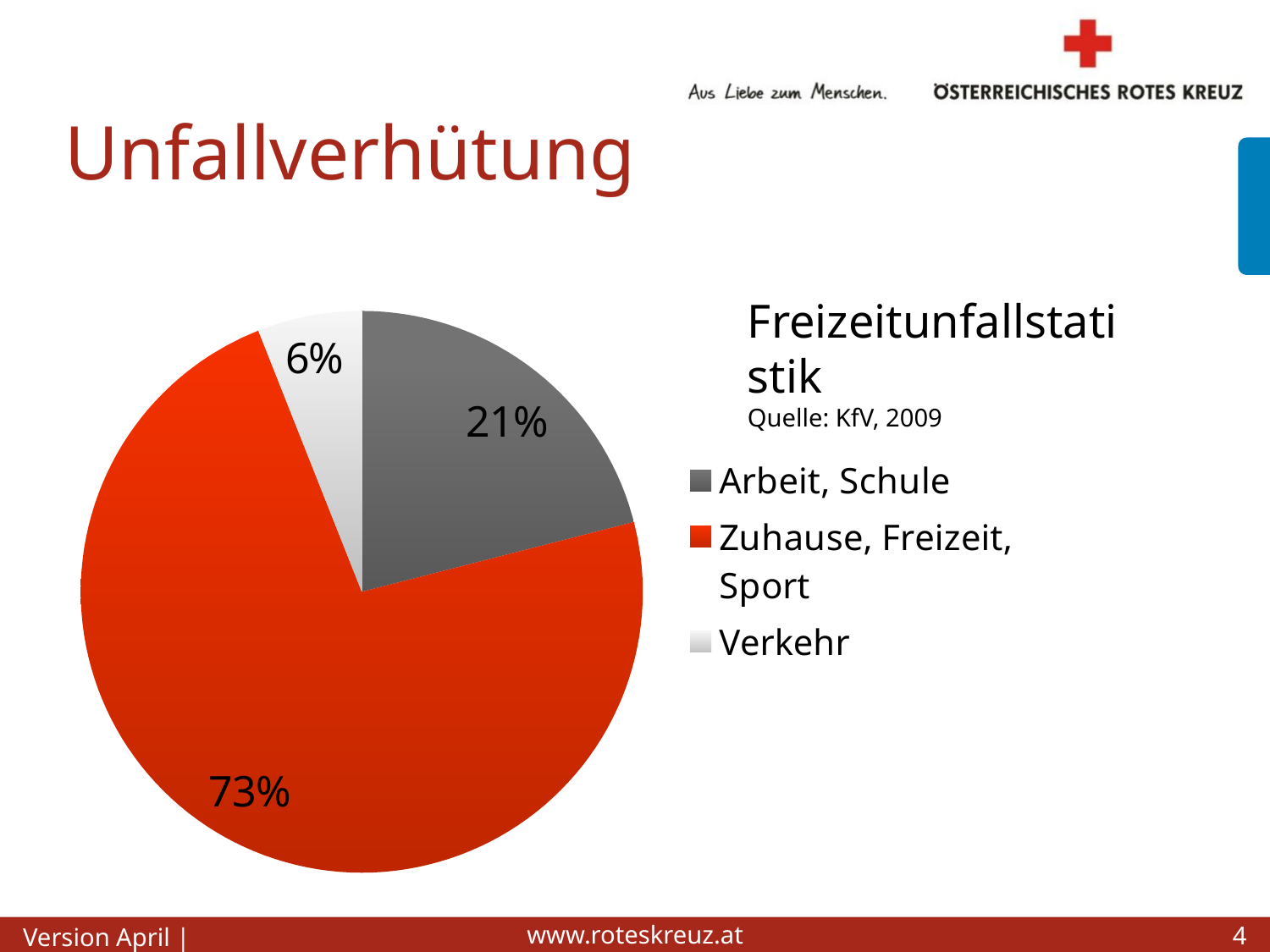
What share of the pie does the 'Verkehr' slice represent? 6% What share of the pie does the 'Arbeit, Schule' slice represent? 21% Which is larger, the 'Arbeit, Schule' slice or the 'Verkehr' slice? Arbeit, Schule Which category has the smallest slice of the pie? Verkehr How many categories does the pie chart show? 3 What kind of chart is shown on the slide? Pie chart What is the difference in percentage points between the 'Zuhause, Freizeit, Sport' slice and the 'Arbeit, Schule' slice? 52 Which category has the largest slice of the pie? Zuhause, Freizeit, Sport What share of the pie does the 'Zuhause, Freizeit, Sport' slice represent? 73% What colour is the 'Verkehr' slice in the pie chart? Light grey What is the difference in percentage points between the 'Arbeit, Schule' slice and the 'Verkehr' slice? 15 What is the title of the chart? Freizeitunfallstatistik